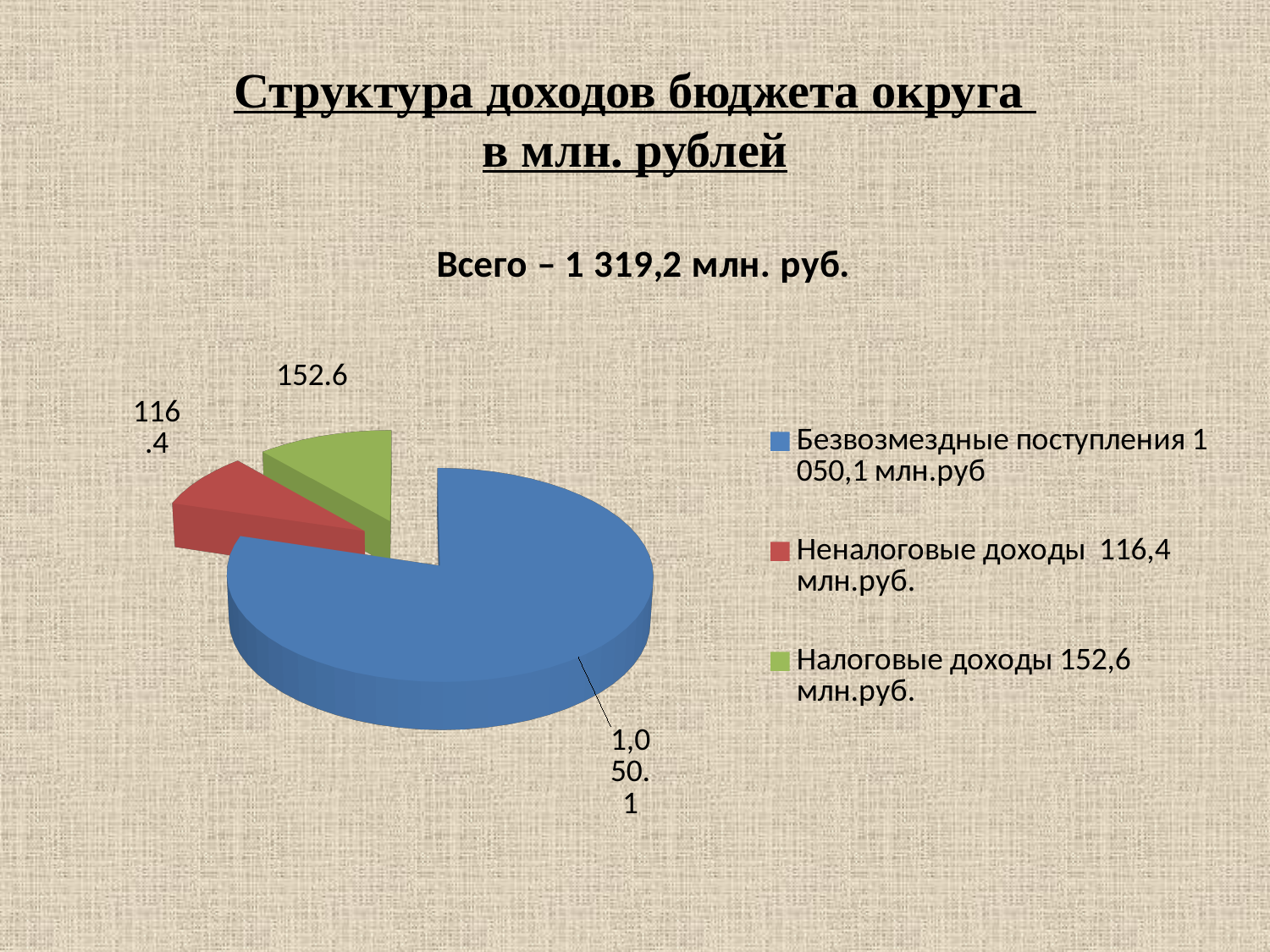
Which category has the largest slice of the pie? Безвозмездные поступления What is the difference between Налоговые доходы and Неналоговые доходы? 36.2 How many slices does the pie chart have? 3 What is the value shown for Неналоговые доходы? 116.4 Which category has the smallest slice of the pie? Неналоговые доходы What kind of chart is shown on the slide? Pie chart What total is stated on the slide for the budget revenues? 1 319,2 млн. руб. What is the value shown for Безвозмездные поступления? 1,050.1 Which is larger, Налоговые доходы or Неналоговые доходы? Налоговые доходы What is the value shown for Налоговые доходы? 152.6 What colour is the slice for Неналоговые доходы? Red What is the difference between Безвозмездные поступления and Налоговые доходы? 897.5